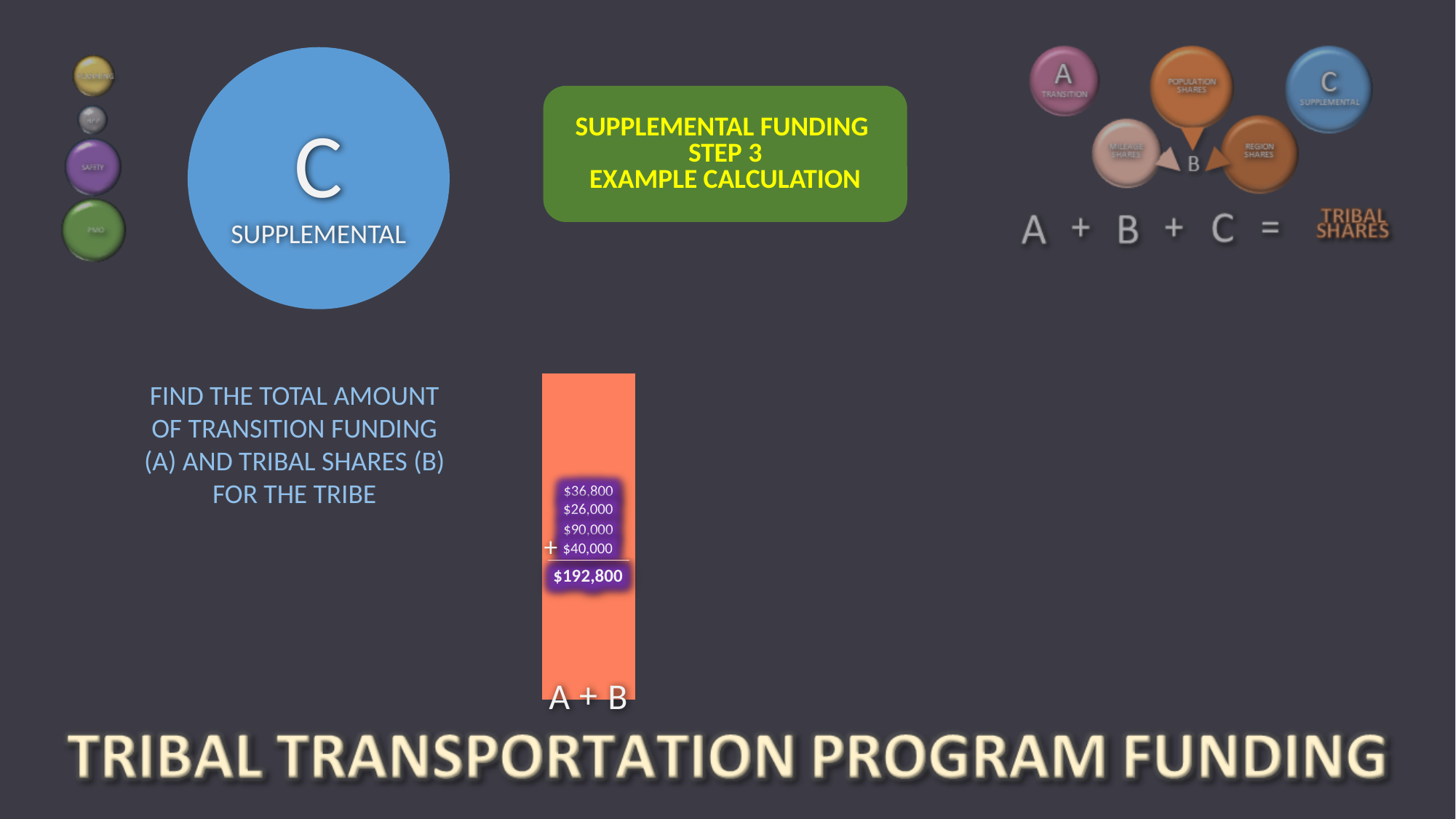
What is the last amount added (after the plus sign) on the A + B bar? $40,000 What is the total shown at the bottom of the stacked values on the A + B bar? $192,800 What is the difference between the $90,000 amount and the $40,000 amount on the A + B bar? $50,000 How many individual dollar amounts are added together on the A + B bar? 4 What label appears directly below the orange bar? A + B What is the first amount listed at the top of the stack on the A + B bar? $36,800 What is the largest of the individual amounts listed on the A + B bar? $90,000 What is the smallest of the individual amounts listed on the A + B bar? $26,000 What kind of chart is used to show the A + B funding amounts? Bar chart Which is larger on the A + B bar, the first amount ($36,800) or the second amount ($26,000)? $36,800 What is the difference between the $36,800 amount and the $26,000 amount on the A + B bar? $10,800 What colour is the bar that holds the funding amounts? Orange